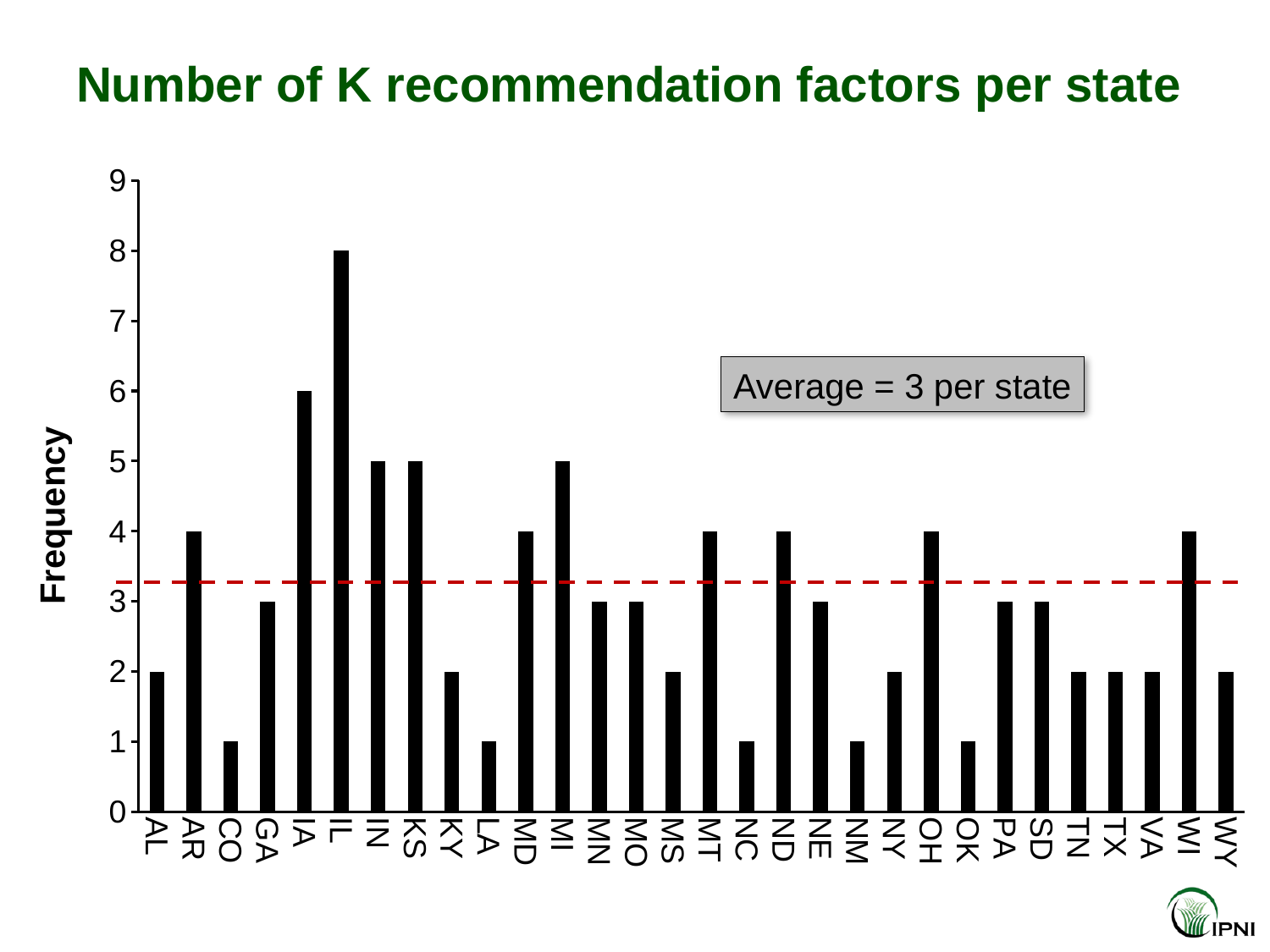
What is the difference in frequency between IL and IA? 2 Is the value for MI greater or less than 4? greater What is the frequency for CO? 1 What is the difference in frequency between AR and WY? 2 Which has a higher frequency, IN or KY? IN What average value does the text box on the chart state? Average = 3 per state What kind of chart is shown on the slide? Bar chart Which state has the highest frequency? IL What is the frequency for IA? 6 What is the frequency for IL? 8 How many states are shown on the x axis? 30 What is the title of the chart? Number of K recommendation factors per state